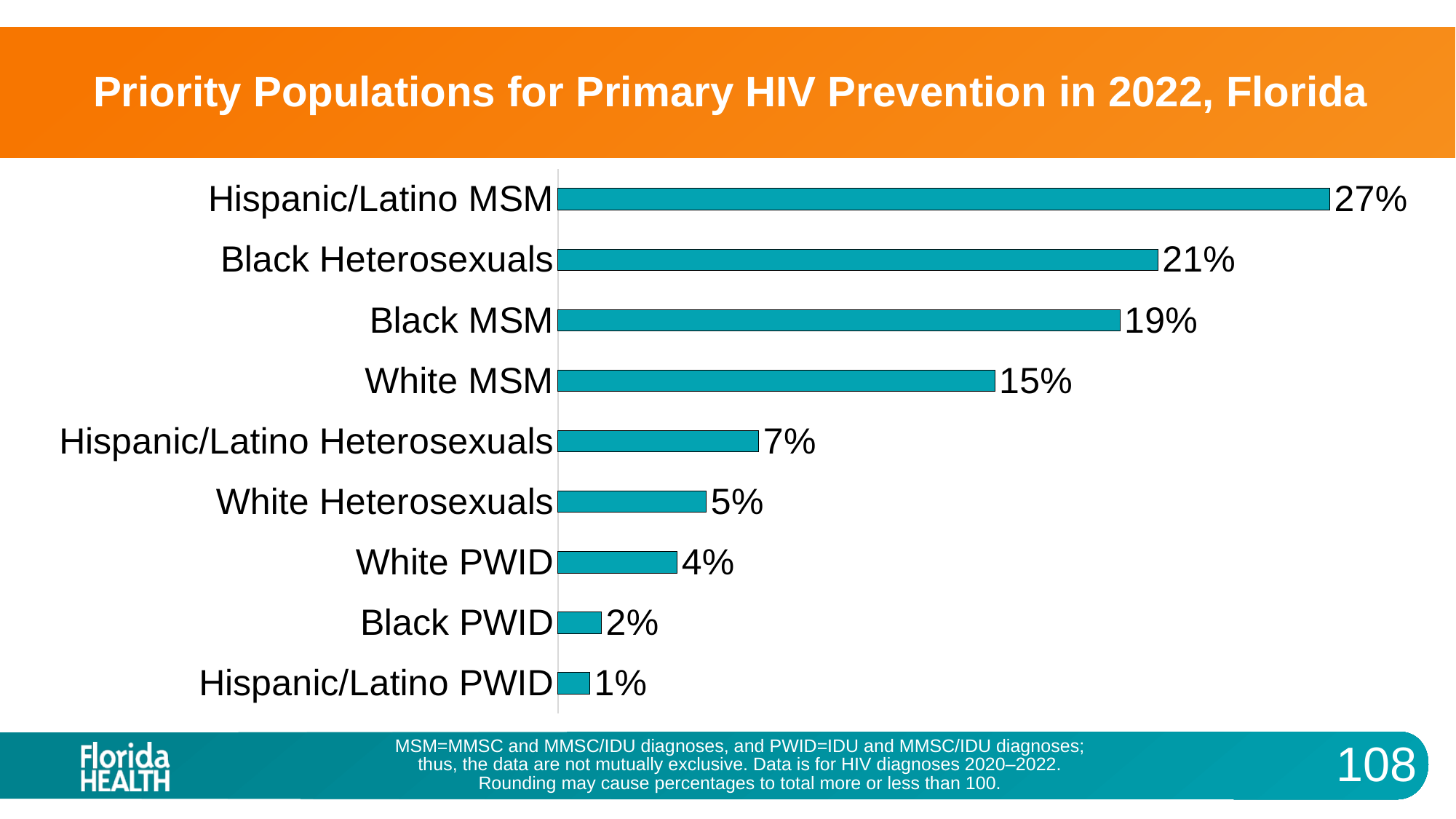
What is the value for White PWID? 4% How many categories are shown in the chart? 9 What is the title of the slide? Priority Populations for Primary HIV Prevention in 2022, Florida Which is larger, the value for Hispanic/Latino Heterosexuals or the value for White Heterosexuals? Hispanic/Latino Heterosexuals What colour are the bars in the chart? Teal Which category has the lowest value? Hispanic/Latino PWID What kind of chart is shown on the slide? Bar chart What is the difference between the values for Black MSM and White MSM? 4% What is the value for Black Heterosexuals? 21% Which category has the highest value? Hispanic/Latino MSM What is the value for Hispanic/Latino MSM? 27% What is the difference between the values for Hispanic/Latino MSM and Black Heterosexuals? 6%